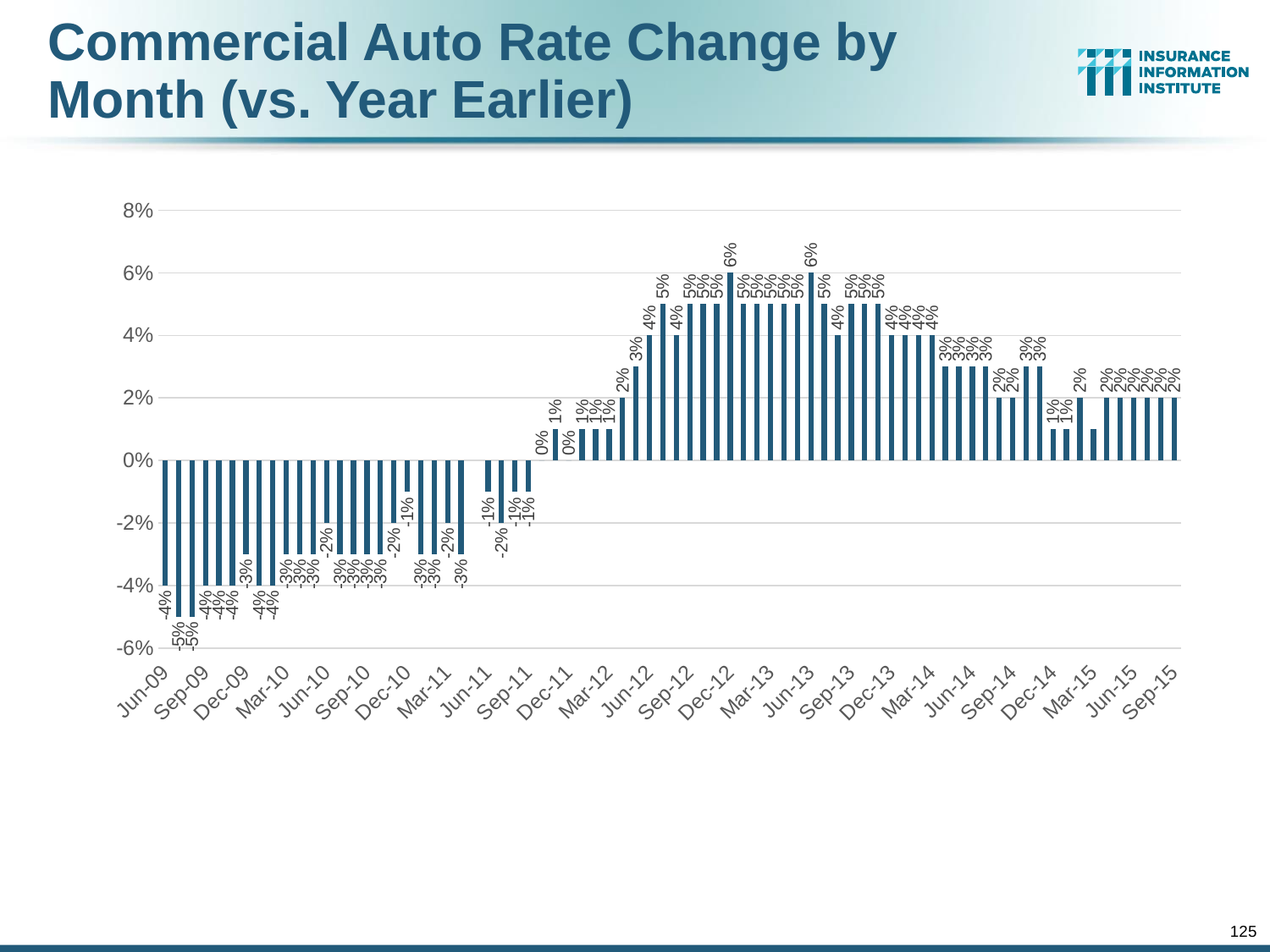
What is the title of the chart? Commercial Auto Rate Change by Month (vs. Year Earlier) What is the difference between the highest value (6%) and the lowest value (-5%) in the chart? 11 percentage points What is the lowest rate change value shown in the chart? -5% Which is larger, the rate change for Jun-09 or for Sep-15? Sep-15 What is the rate change for Jun-09, the first month in the chart? -4% Is the value for Dec-12 greater or less than 4%? greater What is the rate change for Dec-12? 6% What kind of chart is shown on the slide? Bar chart What is the highest rate change value shown in the chart? 6% What is the rate change for Sep-15, the last month in the chart? 2% Do the rate changes generally rise or fall from Jun-09 to Dec-12? Rise How many month labels are shown on the x axis? 26